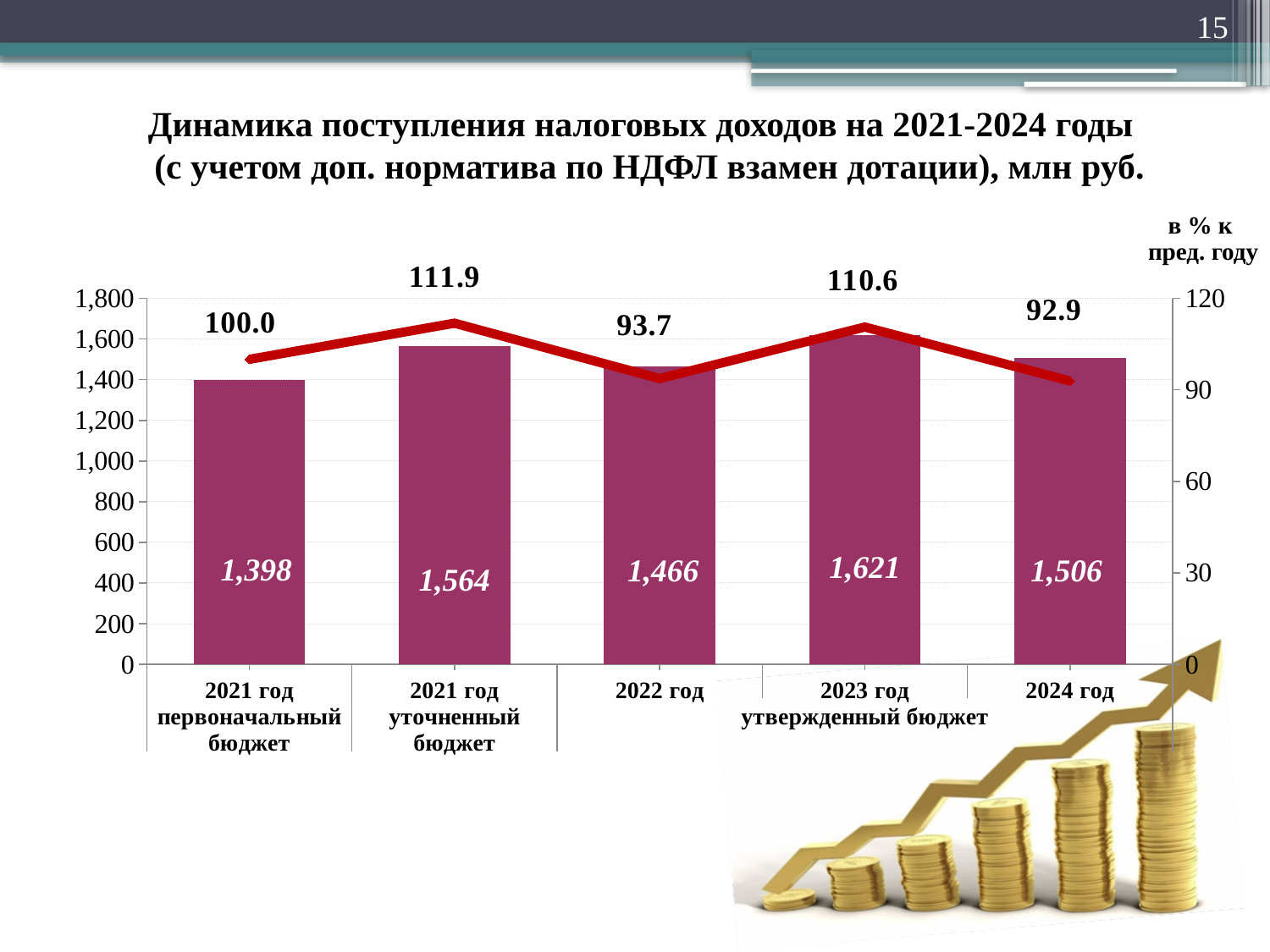
What percentage to the previous year is shown for 2021 год уточненный бюджет? 111.9 What kind of chart is shown on the slide? Bar chart with a line How many bars are plotted in the chart? 5 Does the percentage line rise or fall from 2023 год to 2024 год? Fall What is the tax revenue value (млн руб.) shown for 2023 год? 1,621 What is the lowest percentage to the previous year shown on the line? 92.9 What is the tax revenue value shown for the 2021 год первоначальный бюджет bar? 1,398 Which is larger, the tax revenue for 2021 год уточненный бюджет or for 2022 год? 2021 год уточненный бюджет What is the difference between the tax revenue for 2023 год and 2024 год? 115 Which category has the lowest tax revenue bar? 2021 год первоначальный бюджет Which category has the highest tax revenue bar? 2023 год What percentage to the previous year (в % к пред. году) is shown for 2022 год? 93.7